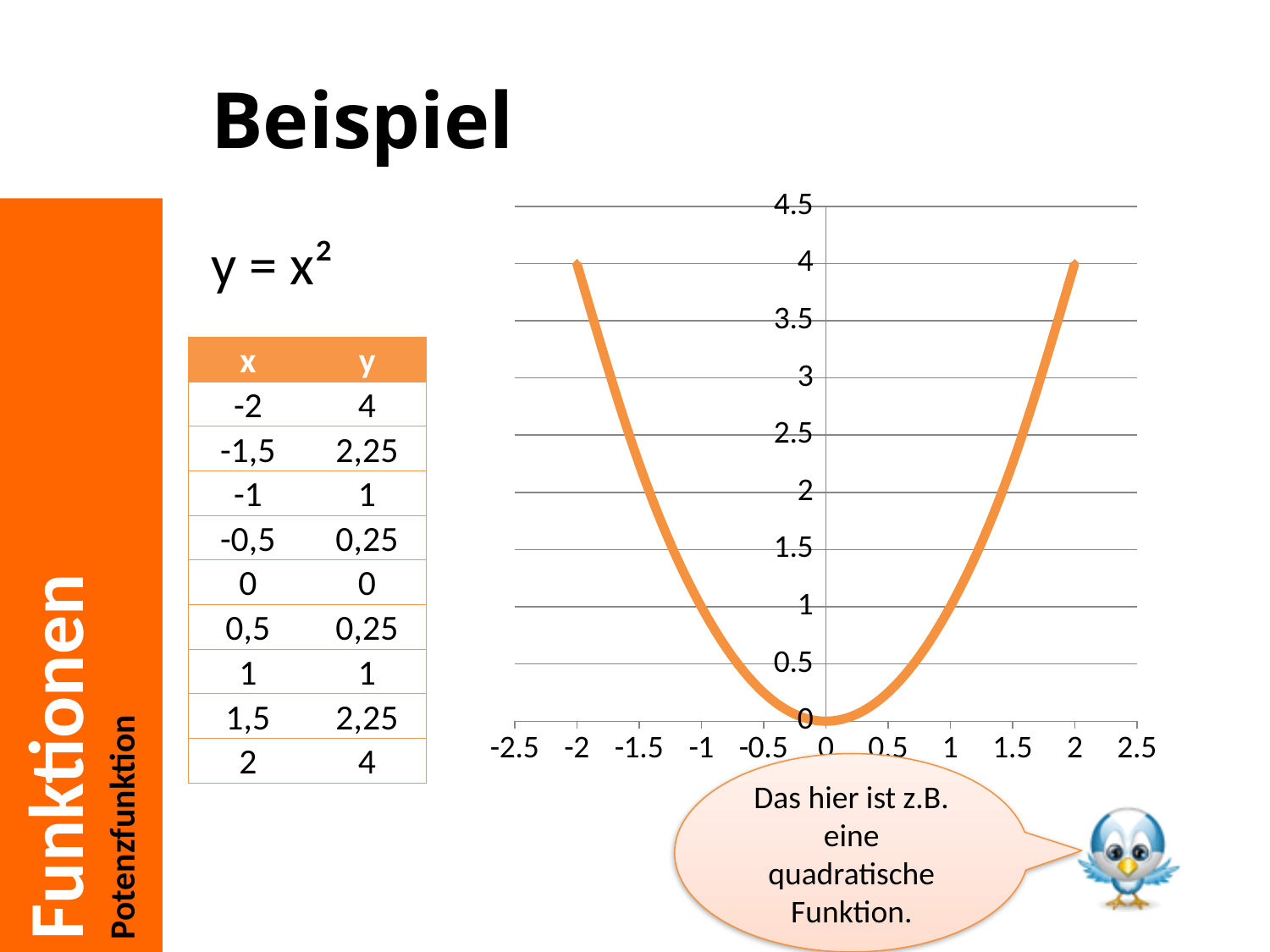
What is the value of y when x = -2? 4 At which x value does the curve reach its lowest y value? 0 What is the value of y when x = 1,5? 2,25 How does the curve behave as x increases from -2 to 2? falls to 0 at x = 0, then rises What kind of chart is shown on the slide? line chart What is the highest y value plotted on the chart? 4 Is the y value at x = 0,5 greater or less than 0.5? less What is the value of y when x = 0? 0 Which has the larger y value, x = -2 or x = -1? x = -2 How many x values are listed in the table of the plotted function? 9 What is the difference between the y value at x = 2 and the y value at x = 1? 3 What is the value of y when x = 1? 1